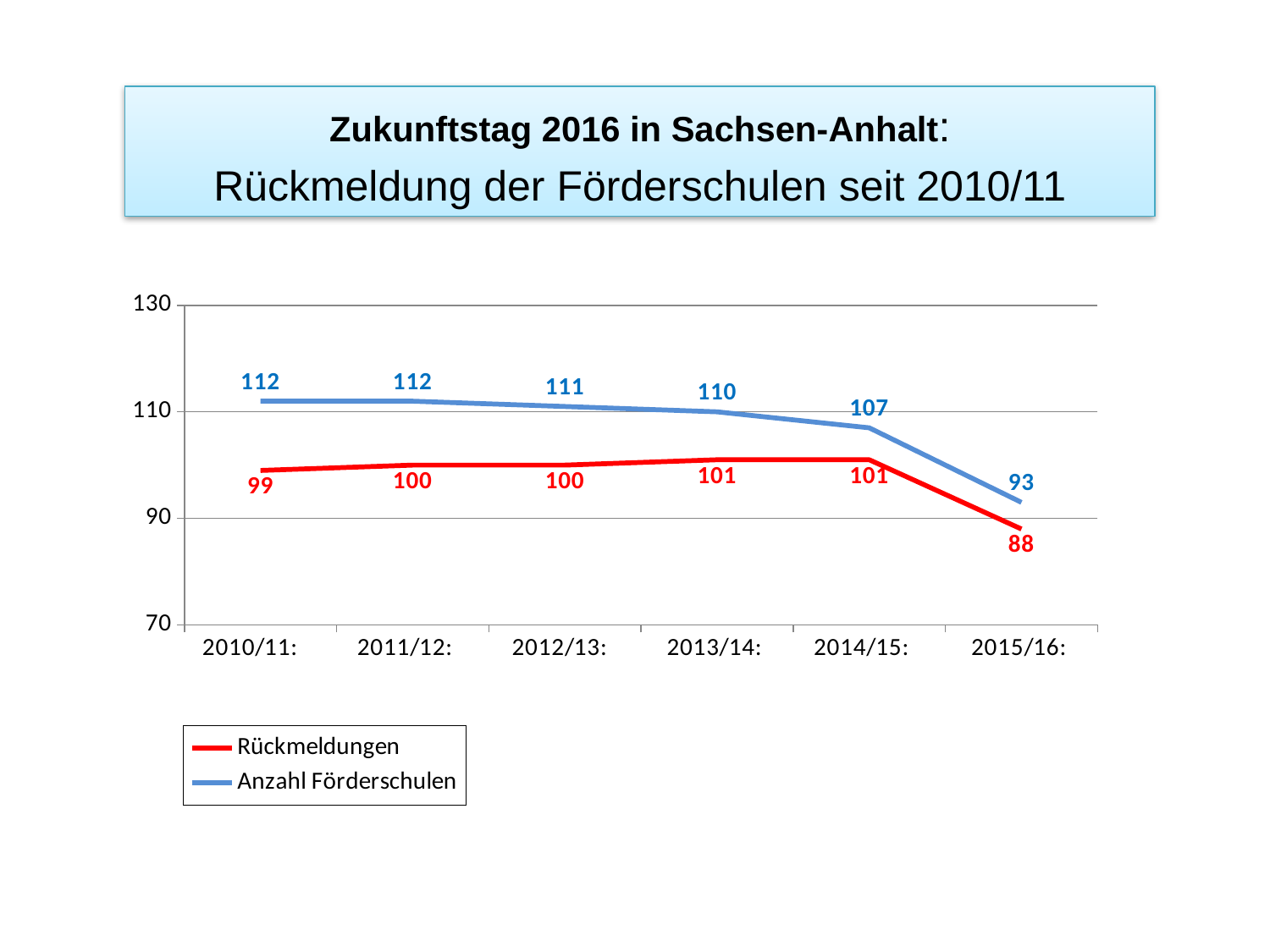
What is the difference between Anzahl Förderschulen and Rückmeldungen in 2014/15? 6 In which year is Anzahl Förderschulen lowest? 2015/16 What is the value of Anzahl Förderschulen for 2015/16? 93 How many series does the legend list? 2 What kind of chart is shown? Line chart Which is larger in 2012/13: Anzahl Förderschulen or Rückmeldungen? Anzahl Förderschulen What is the difference between Anzahl Förderschulen in 2010/11 and in 2015/16? 19 In which year is Rückmeldungen lowest? 2015/16 What is the value of Anzahl Förderschulen for 2013/14? 110 How many years are shown on the x axis? 6 What is the value of Rückmeldungen for 2010/11? 99 Does Anzahl Förderschulen rise or fall from 2014/15 to 2015/16? Fall